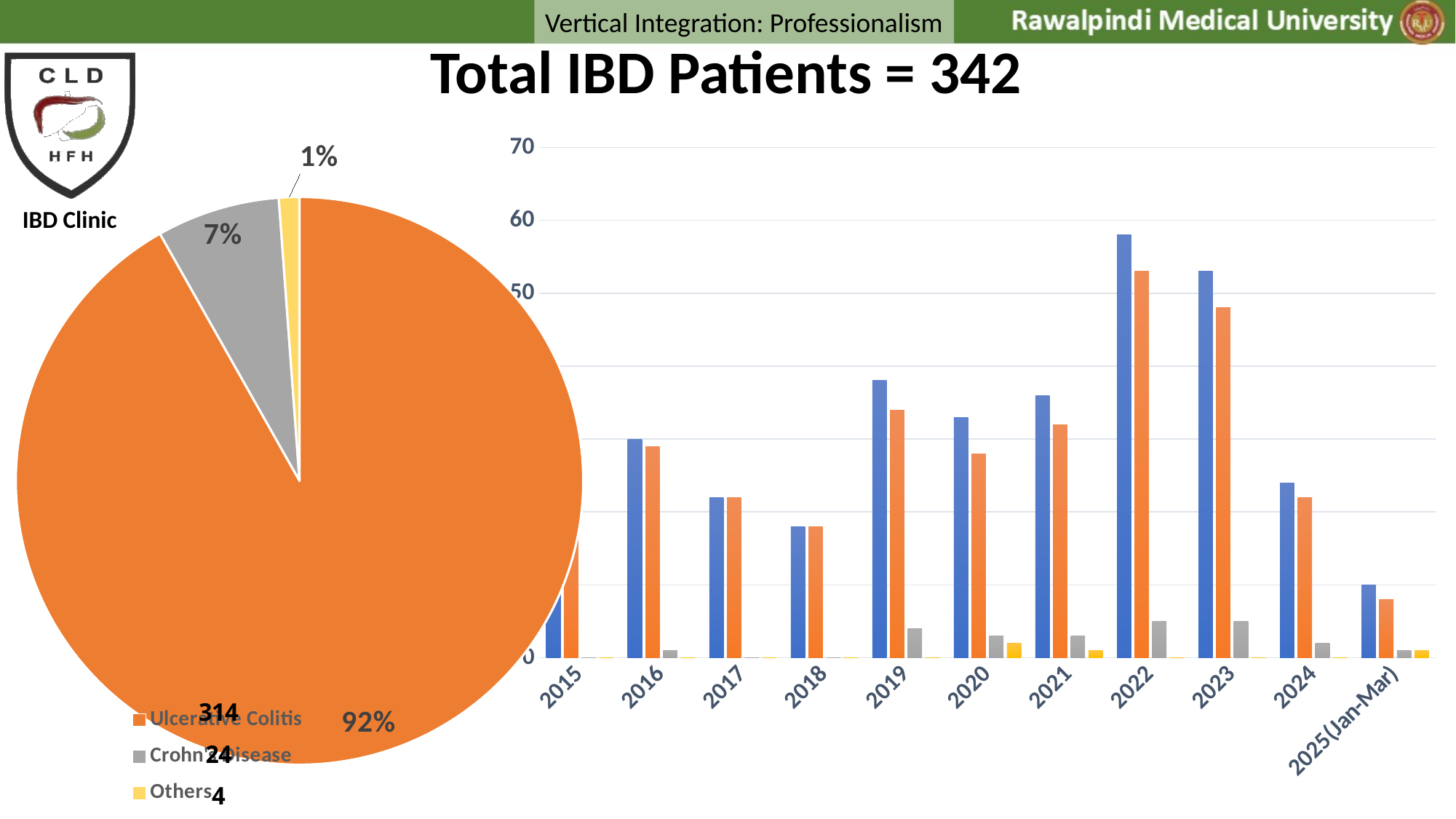
What kind of chart is the chart on the right of the slide showing values by year? Bar chart On the pie chart, what share of IBD patients have Ulcerative Colitis? 92% On the bar chart on the right, is the blue bar for 2022 greater or less than 50? greater On the pie chart, what share of IBD patients have Crohn's Disease? 7% How many slices does the pie chart have? 3 On the bar chart on the right, in which year is the blue bar tallest? 2022 How many year categories are shown on the x axis of the bar chart on the right? 11 On the pie chart, which category has the smallest slice? Others On the bar chart on the right, is the orange bar for 2018 greater or less than 50? less What kind of chart is the chart on the left of the slide? Pie chart On the pie chart, what share is labelled Others? 1% On the pie chart, which category has the largest slice? Ulcerative Colitis